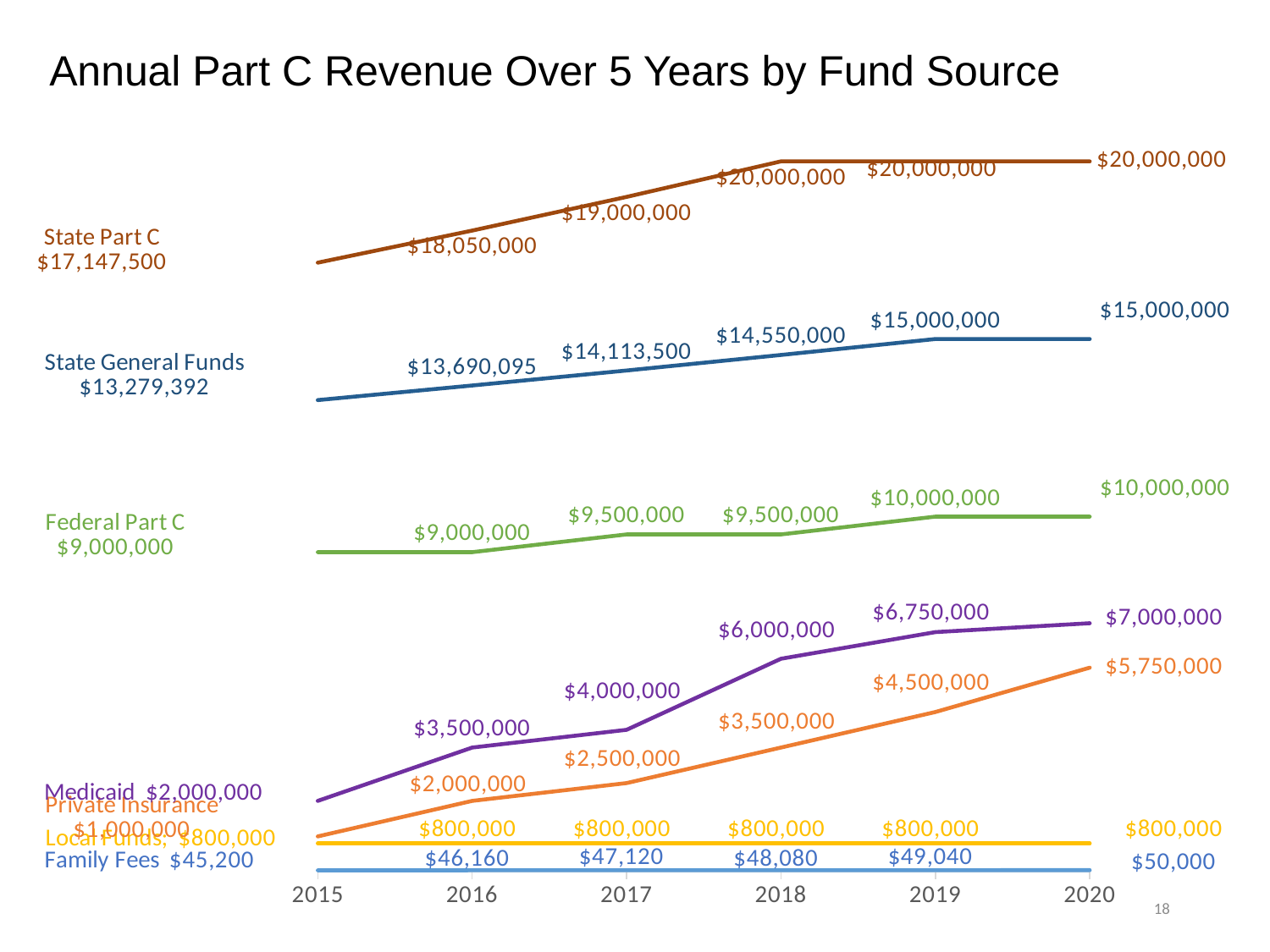
Which fund source has the lowest revenue in 2015? Family Fees How much higher is the Federal Part C revenue in 2020 than in 2015? $1,000,000 What is the Medicaid revenue in 2018? $6,000,000 What is the Family Fees revenue in 2019? $49,040 Which is larger in 2019, Medicaid revenue or Private Insurance revenue? Medicaid Which fund source has the highest revenue in 2020? State Part C Does the Local Funds revenue rise, fall, or stay flat from 2015 to 2020? stays flat What type of chart is shown on the slide? line chart What is the Private Insurance revenue in 2020? $5,750,000 What is the State General Funds revenue in 2016? $13,690,095 What is the State Part C revenue in 2017? $19,000,000 How many years are shown on the x axis? 6